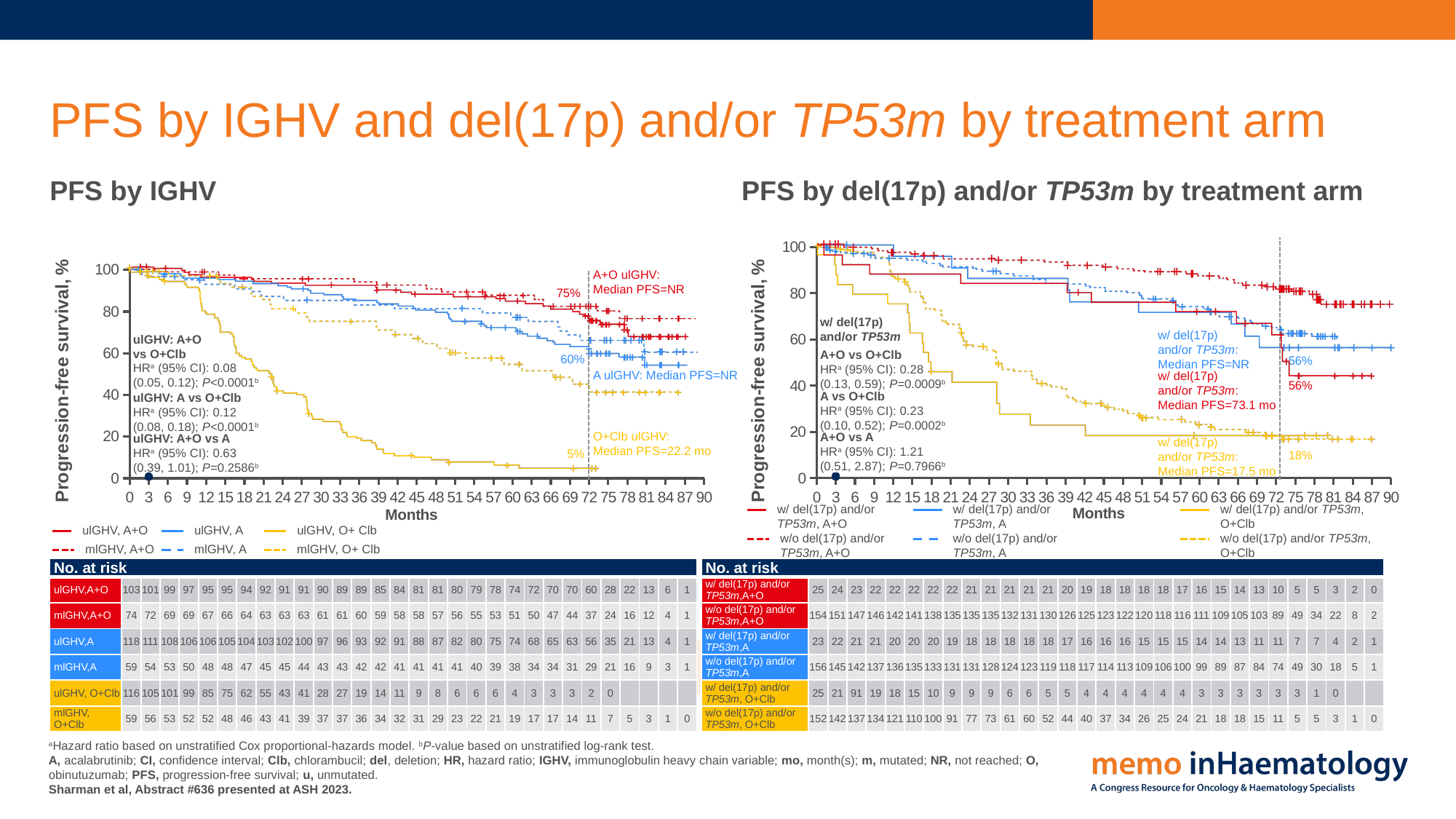
On the 'PFS by IGHV' chart, what is the difference between the labelled PFS percentages of the A+O uIGHV curve (75%) and the A uIGHV curve (60%)? 15% In the 'No. at risk' table under the 'PFS by IGHV' chart, how many uIGHV,A+O patients were at risk at month 0? 103 On the 'PFS by del(17p) and/or TP53m by treatment arm' chart, what is the median PFS for the w/ del(17p) and/or TP53m A+O group? 73.1 mo On the 'PFS by IGHV' chart, what is the labelled progression-free survival percentage for the A+O uIGHV curve at the dashed line? 75% On the 'PFS by IGHV' chart, what is the median PFS for the O+Clb uIGHV group? 22.2 mo On the 'PFS by del(17p) and/or TP53m by treatment arm' chart, what is the hazard ratio for A+O vs A? 1.21 What kind of chart is the 'PFS by IGHV' chart? Line chart (Kaplan-Meier survival curve) On the 'PFS by IGHV' chart, what is the hazard ratio for uIGHV A+O vs O+Clb? 0.08 On the 'PFS by del(17p) and/or TP53m by treatment arm' chart, what is the labelled PFS percentage for the w/ del(17p) and/or TP53m O+Clb curve at the dashed line? 18% On the 'PFS by IGHV' chart, what is the labelled PFS percentage for the uIGHV O+Clb curve at the dashed line? 5% On the 'PFS by del(17p) and/or TP53m by treatment arm' chart, what is the median PFS for the w/ del(17p) and/or TP53m O+Clb group? 17.5 mo On the 'PFS by IGHV' chart, how many series does the legend list? 6